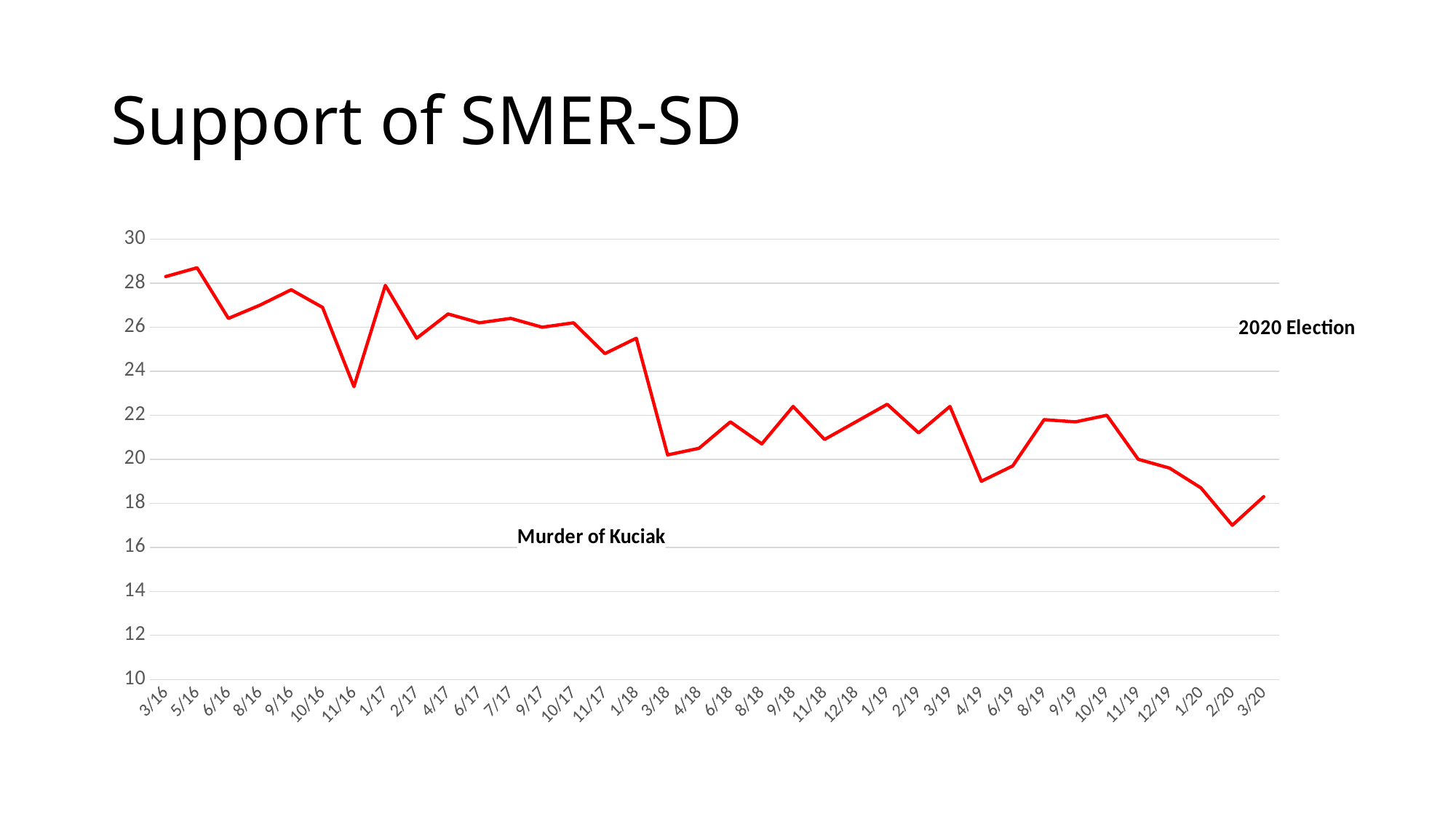
Is the value for 3/18 greater or less than 22? less Which is larger, the value for 1/18 or the value for 3/18? 1/18 Is the value for 4/19 greater or less than 20? less At which time point is the support of SMER-SD lowest? 2/20 Overall, does the support of SMER-SD rise or fall from 3/16 to 3/20? fall Is the value for 3/16 greater or less than 26? greater At which time point is the support of SMER-SD highest? 5/16 How many time points are plotted along the x axis? 36 Which is larger, the value for 3/16 or the value for 3/20? 3/16 What kind of chart is shown on the slide? line chart What event is annotated on the chart near the sharp drop between 1/18 and 3/18? Murder of Kuciak